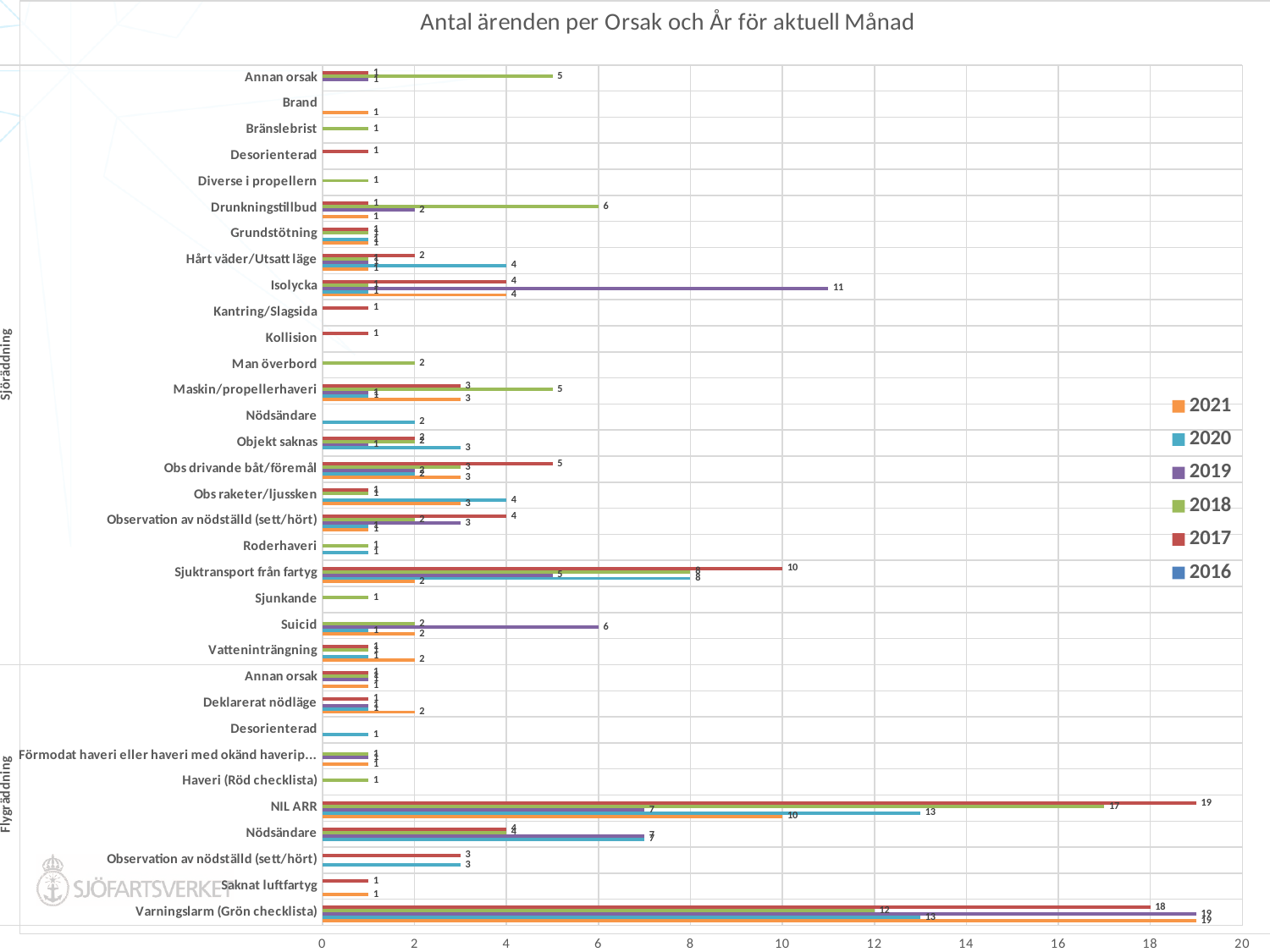
Which year has the highest value in the NIL ARR category? 2017 What is the title of the chart? Antal ärenden per Orsak och År för aktuell Månad What is the difference between the 2017 and 2018 values for NIL ARR? 2 What is the value for 2017 in the Sjuktransport från fartyg category? 10 In the NIL ARR category, which is larger: the value for 2020 or the value for 2021? 2020 What is the value for 2019 in the Isolycka category? 11 Is the value for 2019 in the Isolycka category greater or less than 10? greater What kind of chart is shown on the slide? bar chart How many series (years) does the legend list? 6 What is the value for 2018 in the Drunkningstillbud category? 6 Which year has the highest value in the Isolycka category? 2019 What is the value for 2017 in the NIL ARR category? 19